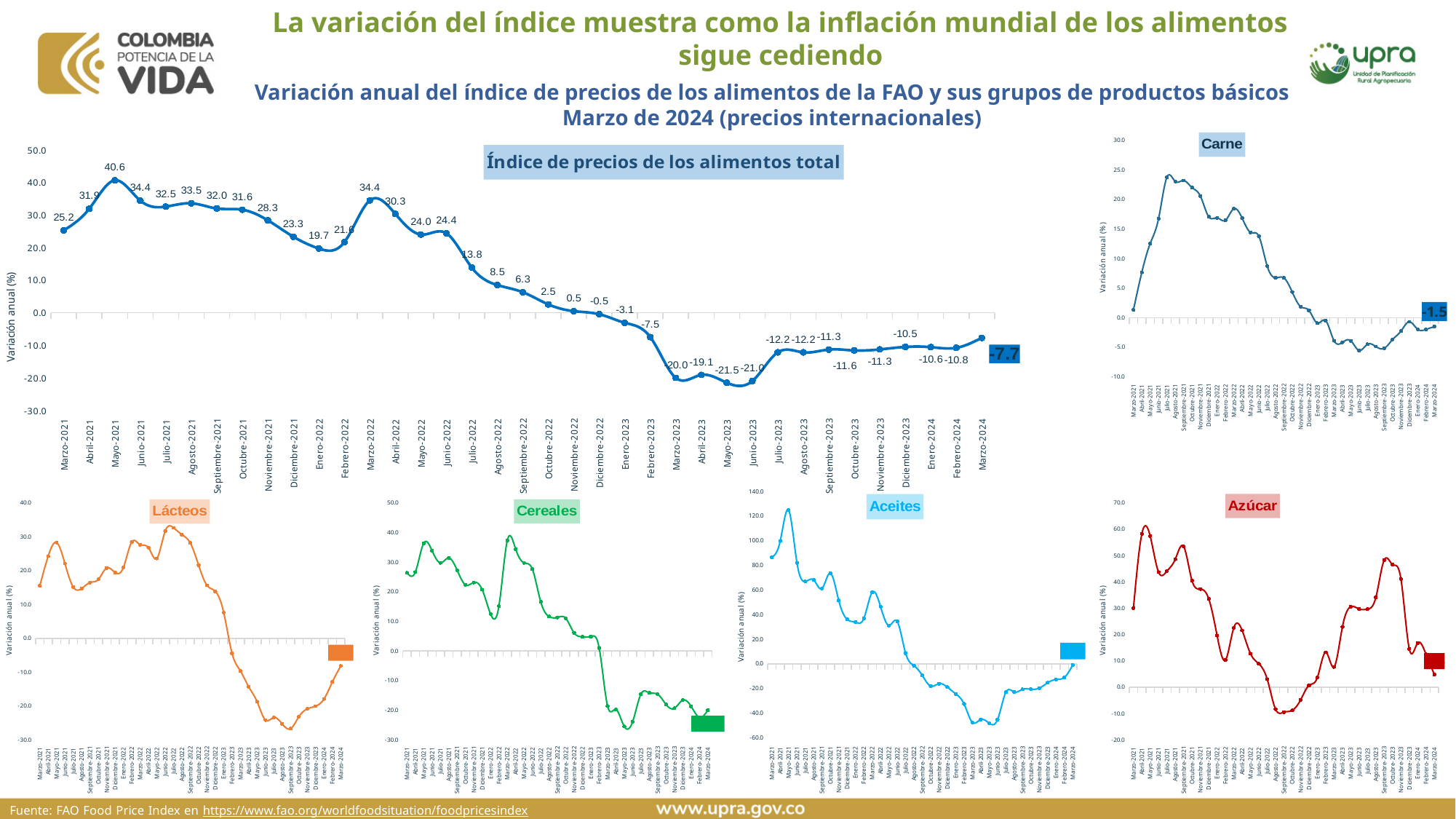
In the 'Índice de precios de los alimentos total' chart, what is the value for Mayo-2021? 40.6 What kind of chart is the 'Índice de precios de los alimentos total' chart? Line chart In the 'Índice de precios de los alimentos total' chart, how many monthly data points are plotted? 37 In the 'Índice de precios de los alimentos total' chart, what is the difference between the values for Marzo-2022 and Abril-2022? 4.1 How many separate charts are shown on the slide? 6 In the 'Carne' chart, what is the value shown for the last point (Marzo-2024)? -1.5 In the 'Índice de precios de los alimentos total' chart, which is larger, the value for Julio-2022 or the value for Agosto-2022? Julio-2022 In the 'Índice de precios de los alimentos total' chart, which month has the highest value? Mayo-2021 In the 'Índice de precios de los alimentos total' chart, which month has the lowest value? Mayo-2023 In the 'Aceites' chart, is the peak value in 2021 greater or less than 100? greater In the 'Índice de precios de los alimentos total' chart, what is the value for Marzo-2024? -7.7 In the 'Índice de precios de los alimentos total' chart, do the values generally rise or fall from Marzo-2022 to Mayo-2023? Fall